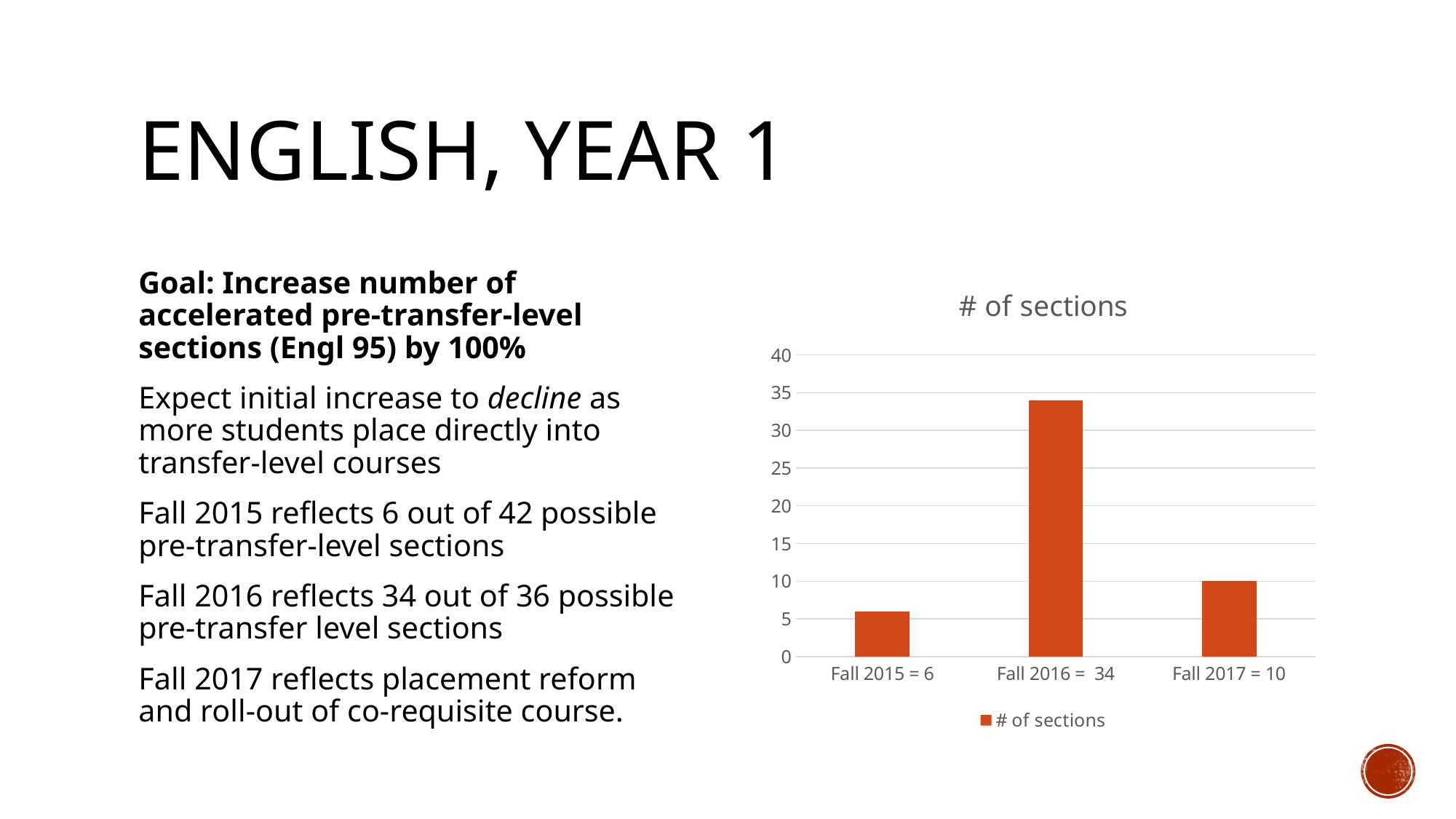
Which term has the highest number of sections? Fall 2016 Which has more sections, Fall 2015 or Fall 2017? Fall 2017 Is the value for Fall 2016 greater or less than 30? greater What is the number of sections for Fall 2015? 6 What is the title of the chart? # of sections What kind of chart is shown on the slide? bar chart What is the number of sections for Fall 2017? 10 Which term has the lowest number of sections? Fall 2015 What is the difference in number of sections between Fall 2016 and Fall 2017? 24 What is the number of sections for Fall 2016? 34 How many series does the legend list? 1 How many bars does the chart have? 3